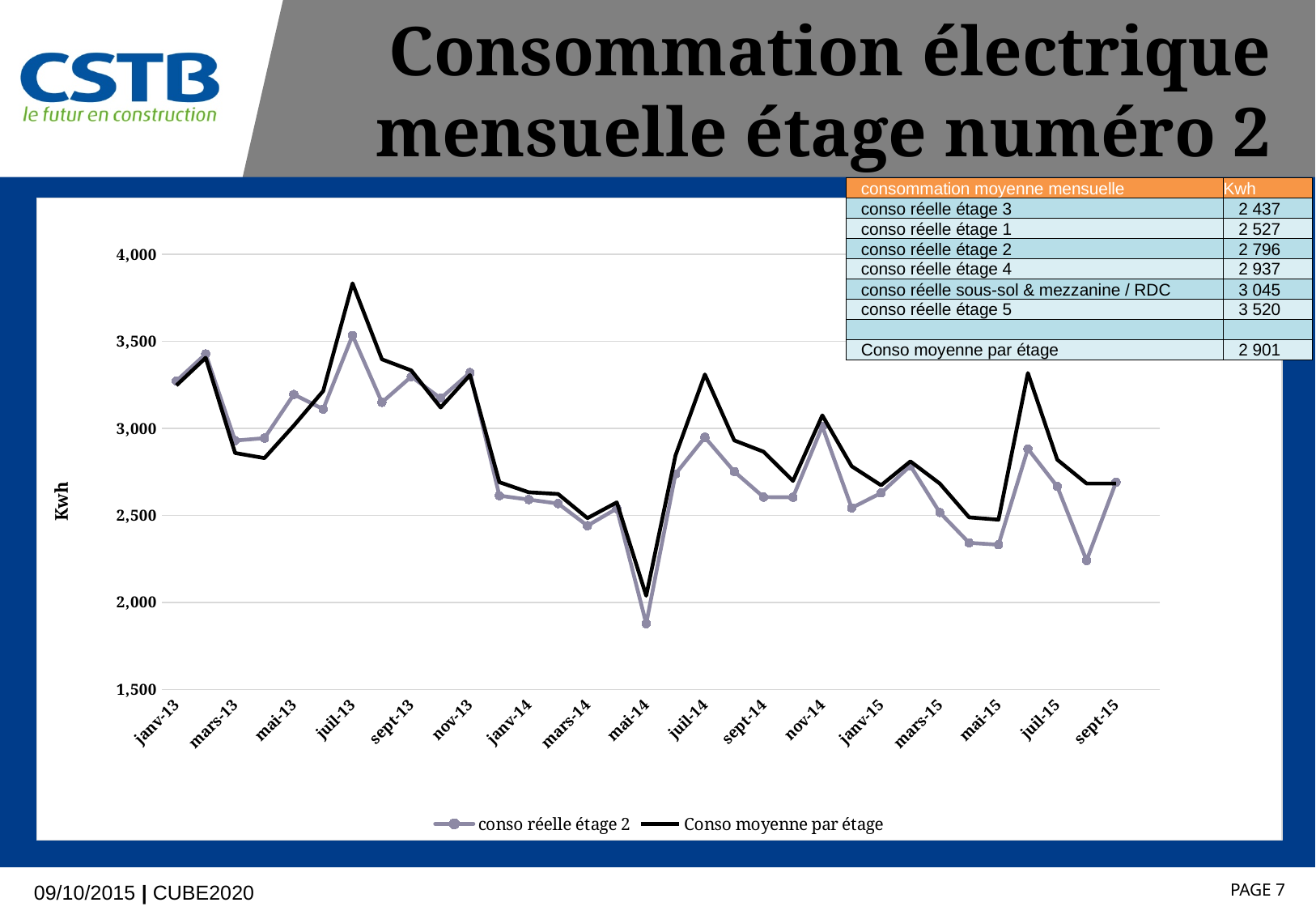
Is the value of conso réelle étage 2 in mai-14 greater or less than 2,000? less In mai-14, which series has the higher value, conso réelle étage 2 or Conso moyenne par étage? Conso moyenne par étage What are the two series named in the chart legend? conso réelle étage 2 and Conso moyenne par étage Is the value of Conso moyenne par étage in juil-13 greater or less than 3,500? greater Does the conso réelle étage 2 series rise or fall between juil-13 and mai-14? fall What kind of chart is shown on the slide? line chart How many series does the chart legend list? 2 In which month does the Conso moyenne par étage series reach its highest value? juil-13 What is the label on the vertical axis of the chart? Kwh Is the value of conso réelle étage 2 in janv-13 greater or less than 3,000? greater In which month does the conso réelle étage 2 series reach its highest value? juil-13 In which month does the conso réelle étage 2 series reach its lowest value? mai-14